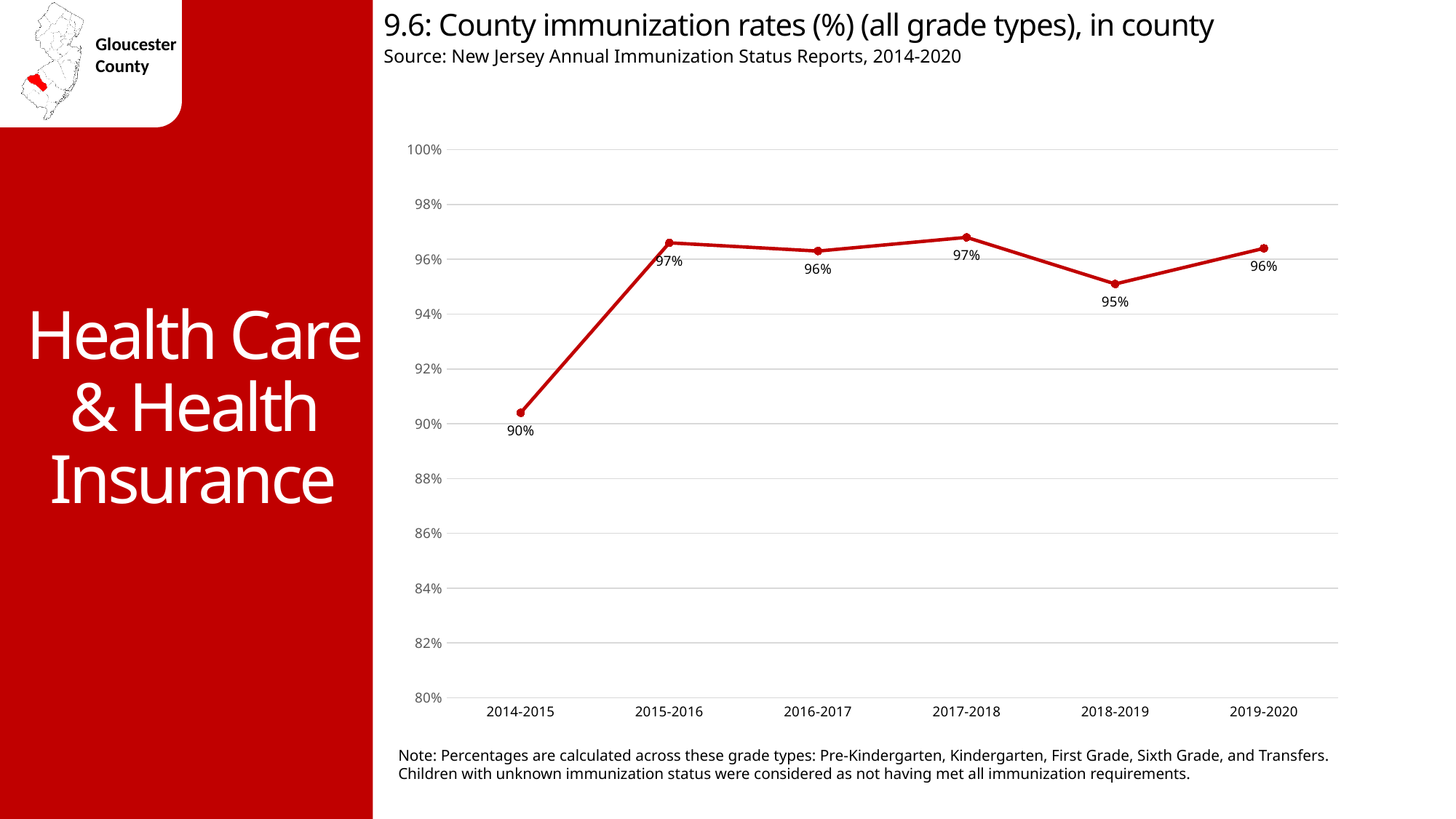
Does the immunization rate rise or fall from 2017-2018 to 2018-2019? fall What kind of chart is shown on the slide? line chart What is the county immunization rate for 2016-2017? 96% What is the county immunization rate for 2019-2020? 96% Which school year has the lowest immunization rate? 2014-2015 How many school years are plotted on the chart? 6 Is the value for 2018-2019 greater or less than 94%? greater What is the county immunization rate for 2014-2015? 90% What is the county immunization rate for 2018-2019? 95% Which has a higher immunization rate, 2014-2015 or 2018-2019? 2018-2019 Is the value for 2014-2015 greater or less than 92%? less By how many percentage points did the immunization rate change from 2014-2015 to 2015-2016? 7 percentage points